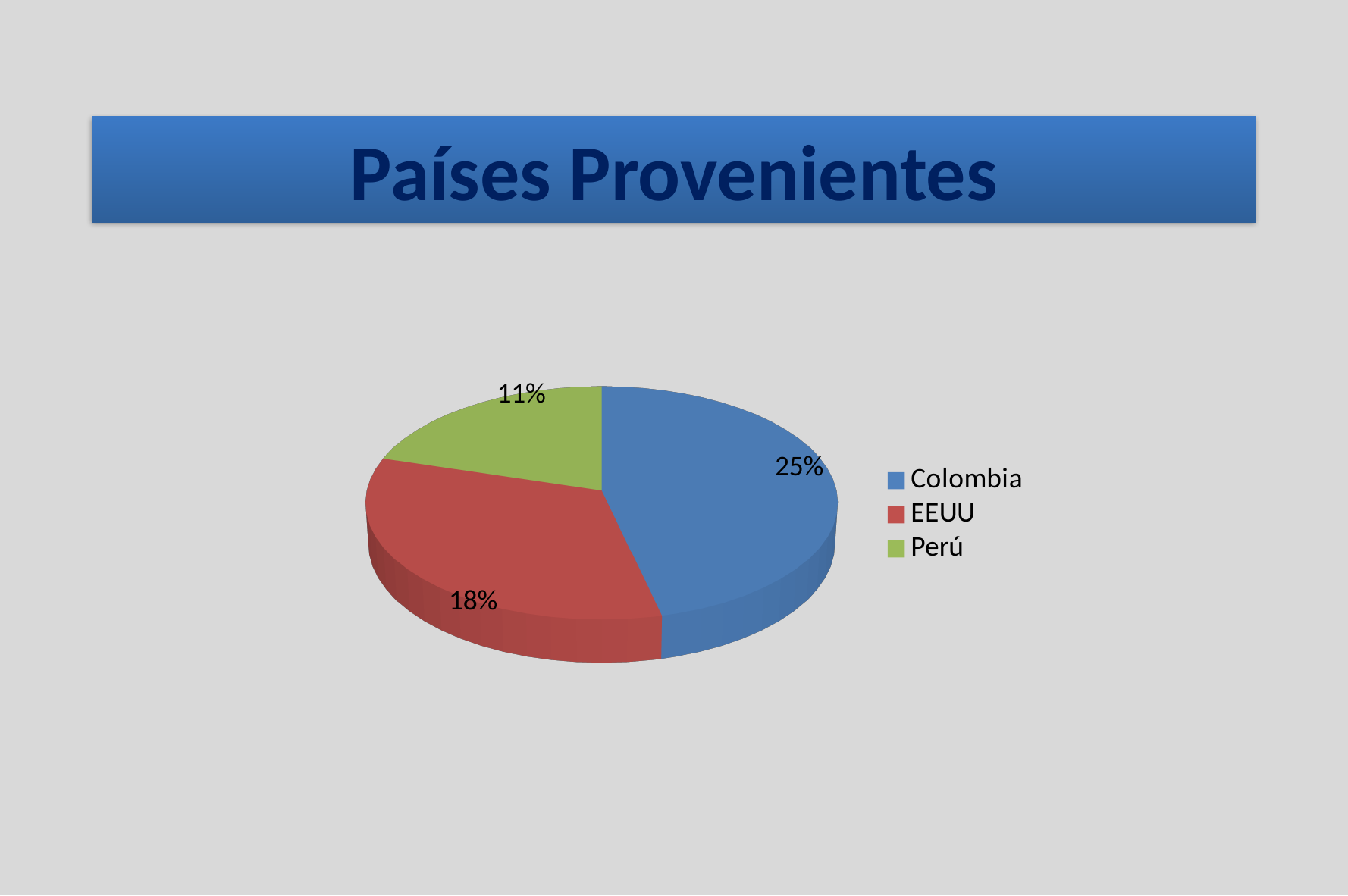
What value is labelled on the EEUU slice of the pie chart? 18% What colour is the Perú slice in the pie chart? green What value is labelled on the Perú slice of the pie chart? 11% What type of chart is shown on the slide? pie chart What is the difference between the labelled values for Colombia and EEUU in the pie chart? 7% Which category has the smallest slice in the pie chart? Perú What is the title of the slide containing the pie chart? Países Provenientes Which is larger in the pie chart, the EEUU slice or the Perú slice? EEUU How many categories does the pie chart show? 3 Which category has the largest slice in the pie chart? Colombia How many entries does the legend of the pie chart list? 3 What value is labelled on the Colombia slice of the pie chart? 25%